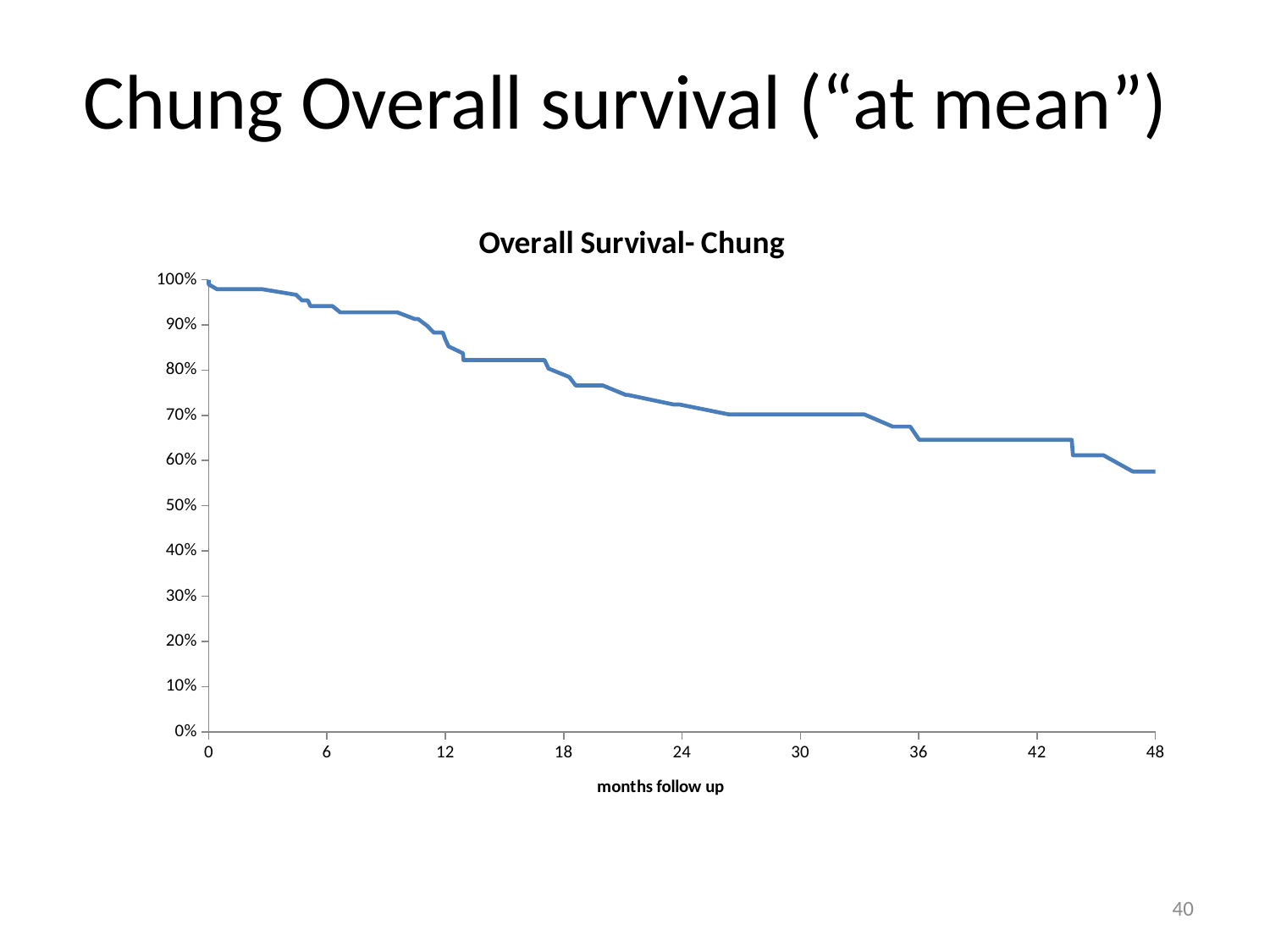
Is the overall survival at 18 months follow up greater or less than 70%? greater Is the overall survival at 36 months follow up greater or less than 60%? greater What is the label of the x axis? months follow up What is the title of the chart? Overall Survival- Chung Does overall survival rise or fall as months of follow up increase? fall Is the overall survival at 12 months follow up greater or less than 80%? greater What is the overall survival value at 0 months follow up? 100% What kind of chart is shown on the slide? line chart